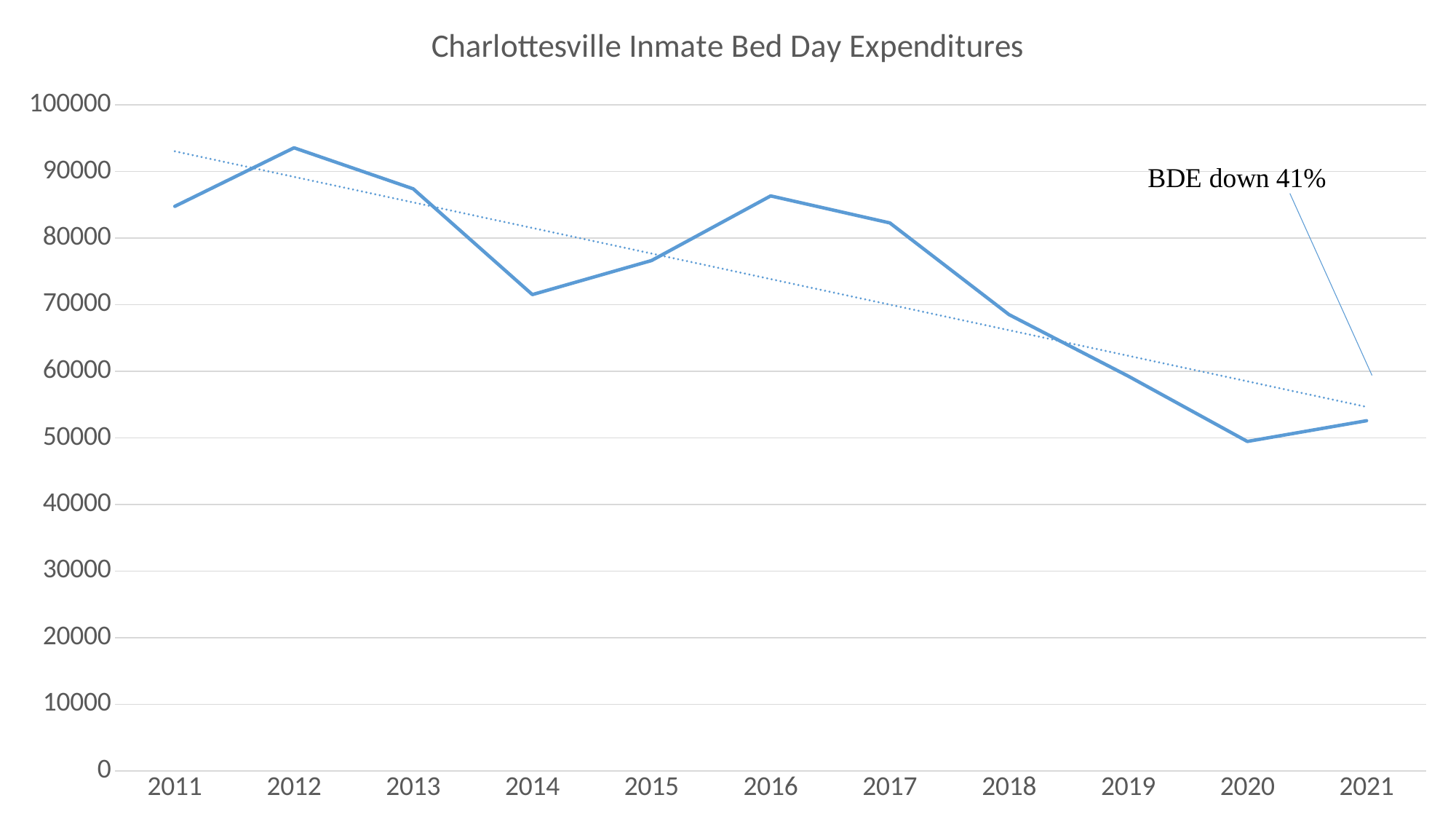
Is the value for 2012 greater or less than 90000? greater What is the title of the chart? Charlottesville Inmate Bed Day Expenditures Is the value for 2014 greater or less than 80000? less Which year has the lowest inmate bed day expenditure? 2020 How many years are plotted along the x axis? 11 Which year has the highest inmate bed day expenditure? 2012 What does the text annotation on the chart say? BDE down 41% Which year has the larger expenditure, 2013 or 2014? 2013 What kind of chart is shown on the slide? line chart Overall, do the expenditures rise or fall from 2011 to 2021? fall Is the value for 2016 greater or less than 80000? greater